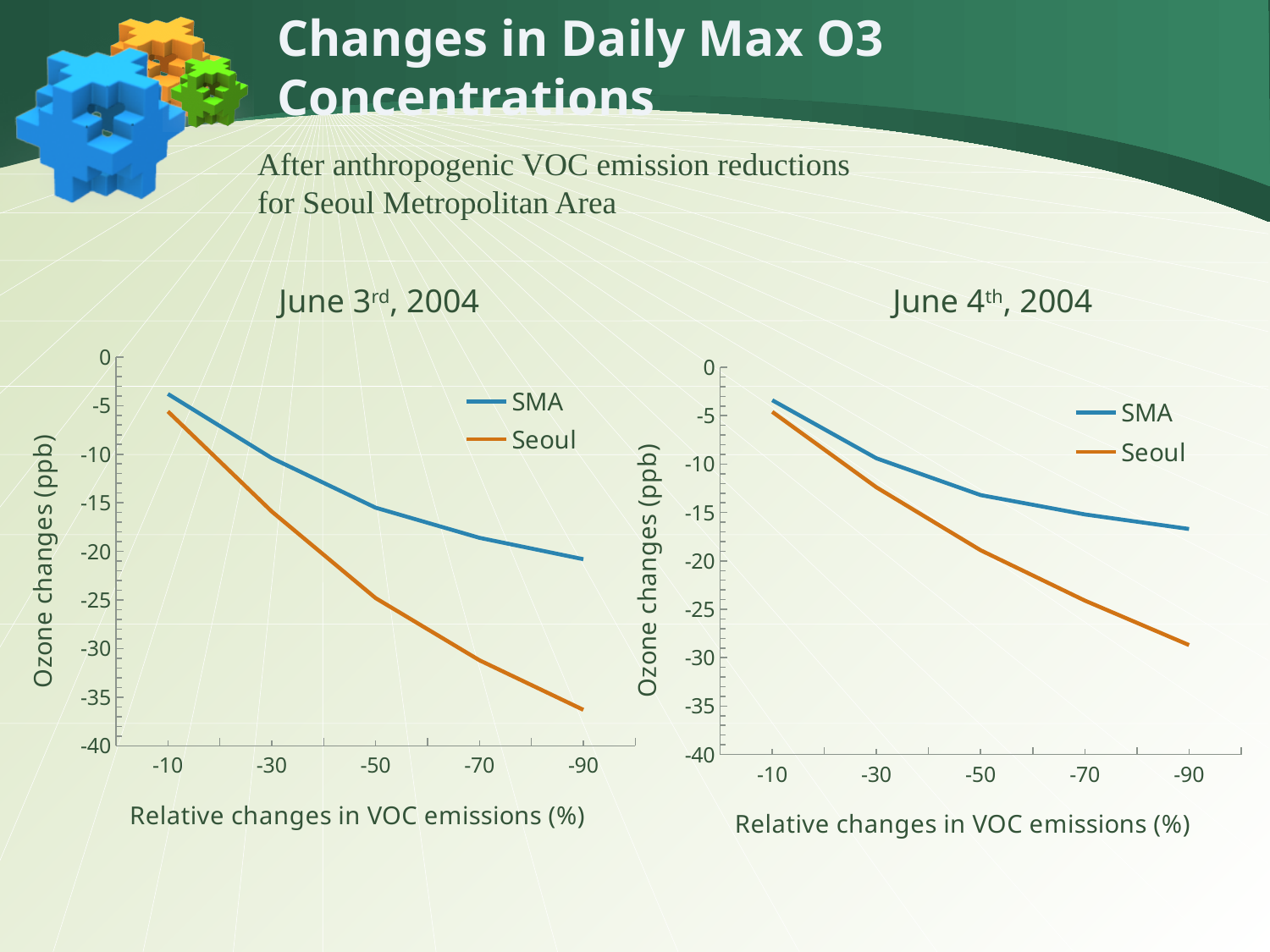
How many series does the legend of the June 4th, 2004 chart list? 2 In the June 3rd, 2004 chart, is the SMA value at -90 greater or less than -15? less In the June 3rd, 2004 chart, do the ozone changes for Seoul rise or fall as the VOC emission reduction goes from -10 to -90? fall What kind of chart is the June 3rd, 2004 chart? line chart In the June 4th, 2004 chart, is the SMA value at -10 greater or less than -10? greater In the June 3rd, 2004 chart, is the Seoul value at -90 greater or less than -30? less In the June 4th, 2004 chart, do the SMA values rise or fall along the x axis from -10 to -90? fall How many x-axis tick values are labelled on the June 3rd, 2004 chart? 5 What is the x-axis title of the June 3rd, 2004 chart? Relative changes in VOC emissions (%) In the June 3rd, 2004 chart, at -90 on the x axis, which series has the higher (less negative) ozone change, SMA or Seoul? SMA What is the y-axis title of the June 4th, 2004 chart? Ozone changes (ppb)